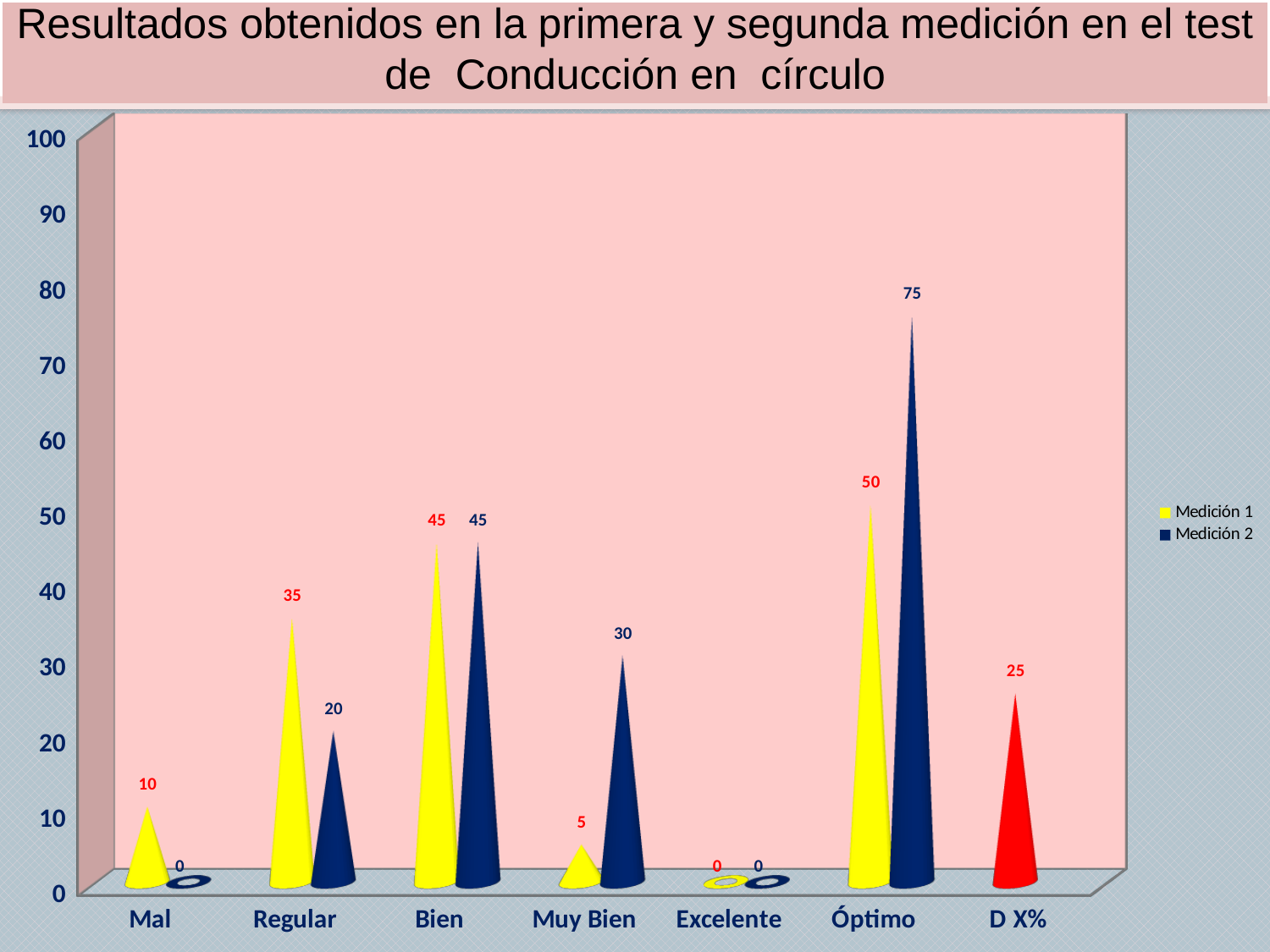
What is the value for Medición 1 in the Mal category? 10 What is the value for Medición 2 in the Muy Bien category? 30 What kind of chart is shown on the slide? Bar chart Which category has the highest value for Medición 1? Óptimo Which category has the highest value for Medición 2? Óptimo What is the difference between Medición 2 and Medición 1 in the Óptimo category? 25 How many series does the legend list? 2 How many categories are shown on the x axis? 7 What is the value for Medición 1 in the Regular category? 35 What is the value for Medición 2 in the Óptimo category? 75 In the Muy Bien category, which is larger, Medición 1 or Medición 2? Medición 2 What is the difference between Medición 1 and Medición 2 in the Regular category? 15